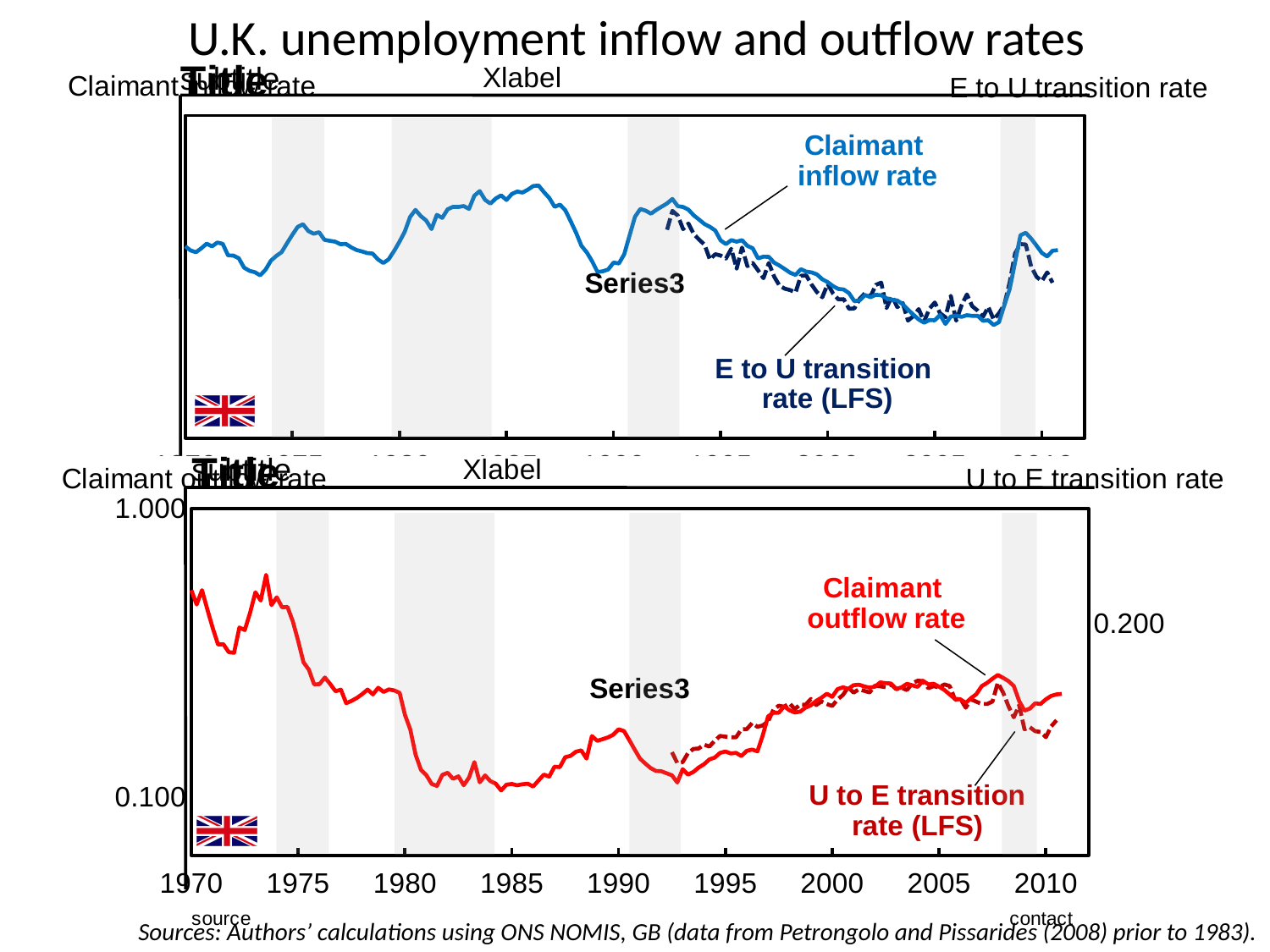
In the top chart, which series is drawn as a dashed line? E to U transition rate (LFS) In the bottom chart, does the Claimant outflow rate rise or fall between 1990 and 2005? rise In the bottom chart, which series is drawn as a dashed line? U to E transition rate (LFS) In the bottom chart, is the Claimant outflow rate in 1985 greater or less than 1.000? less In the bottom chart, is the Claimant outflow rate in 1973 greater or less than 0.100? greater What kind of chart is the bottom chart on the slide? line chart In the top chart, does the Claimant inflow rate rise or fall between 1993 and 2005? fall What is the overall title shown above the two charts? U.K. unemployment inflow and outflow rates What kind of chart is the top chart on the slide? line chart How many series are plotted in the top chart? 3 In the bottom chart, does the Claimant outflow rate rise or fall between 1970 and 1985? fall How many series are plotted in the bottom chart? 3